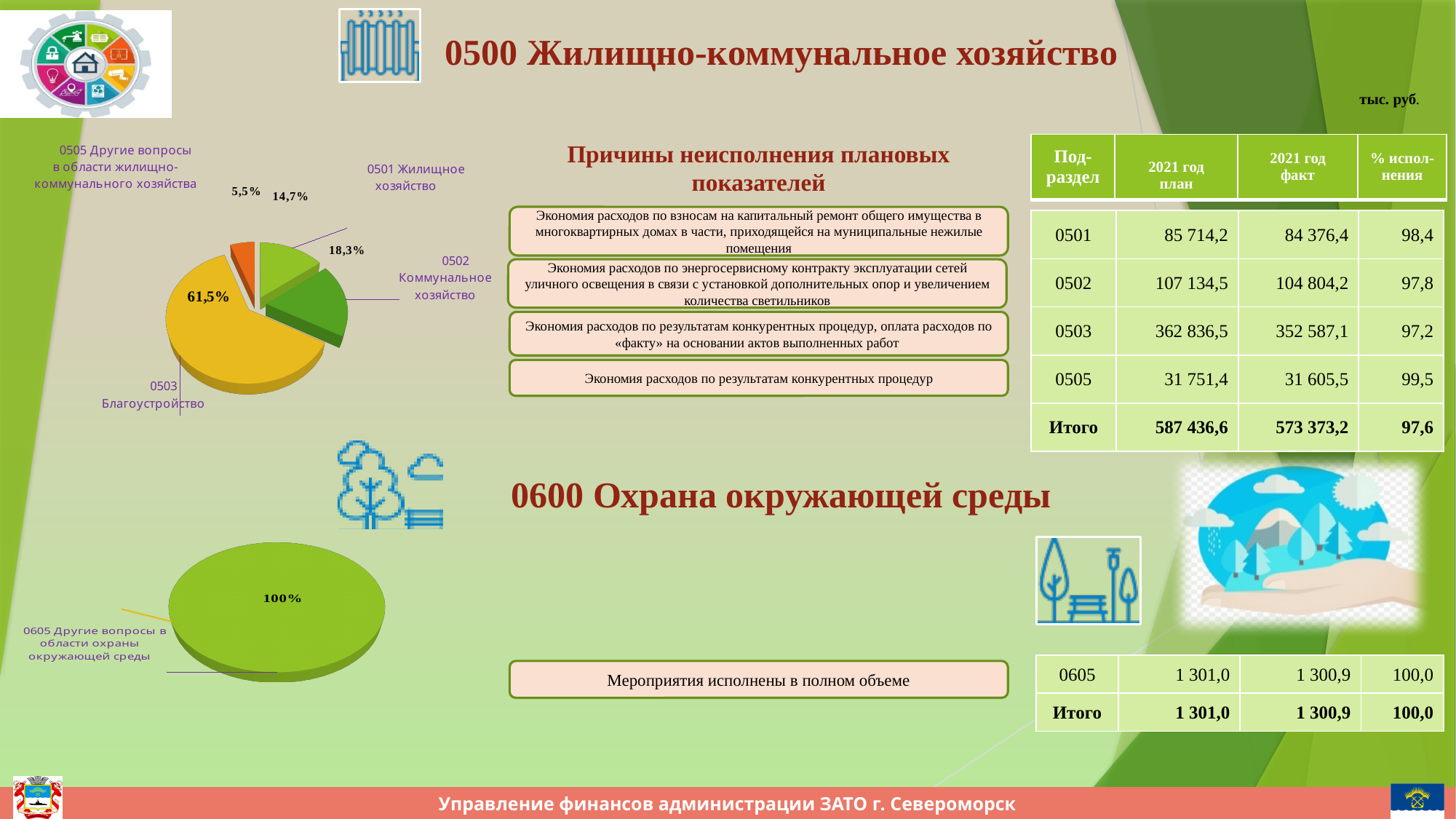
In the top-left pie chart (0500 Жилищно-коммунальное хозяйство), which category has the largest share? 0503 Благоустройство In the bottom-left pie chart (0600 Охрана окружающей среды), what share does 0605 Другие вопросы в области охраны окружающей среды have? 100% In the top-left pie chart (0500 Жилищно-коммунальное хозяйство), what share does 0502 Коммунальное хозяйство have? 18,3% In the top-left pie chart (0500 Жилищно-коммунальное хозяйство), what colour is the slice for 0503 Благоустройство? Yellow What type of chart is used for 0500 Жилищно-коммунальное хозяйство on the left of the slide? Pie chart In the top-left pie chart (0500 Жилищно-коммунальное хозяйство), which is larger: 0501 Жилищное хозяйство or 0502 Коммунальное хозяйство? 0502 Коммунальное хозяйство How many slices does the top-left pie chart (0500 Жилищно-коммунальное хозяйство) have? 4 In the top-left pie chart (0500 Жилищно-коммунальное хозяйство), what is the difference in percentage points between 0503 Благоустройство and 0502 Коммунальное хозяйство? 43,2 In the top-left pie chart (0500 Жилищно-коммунальное хозяйство), which category has the smallest share? 0505 Другие вопросы в области жилищно-коммунального хозяйства In the top-left pie chart (0500 Жилищно-коммунальное хозяйство), what share does 0501 Жилищное хозяйство have? 14,7% In the top-left pie chart (0500 Жилищно-коммунальное хозяйство), what share does 0503 Благоустройство have? 61,5% In the top-left pie chart (0500 Жилищно-коммунальное хозяйство), what share does 0505 Другие вопросы в области жилищно-коммунального хозяйства have? 5,5%